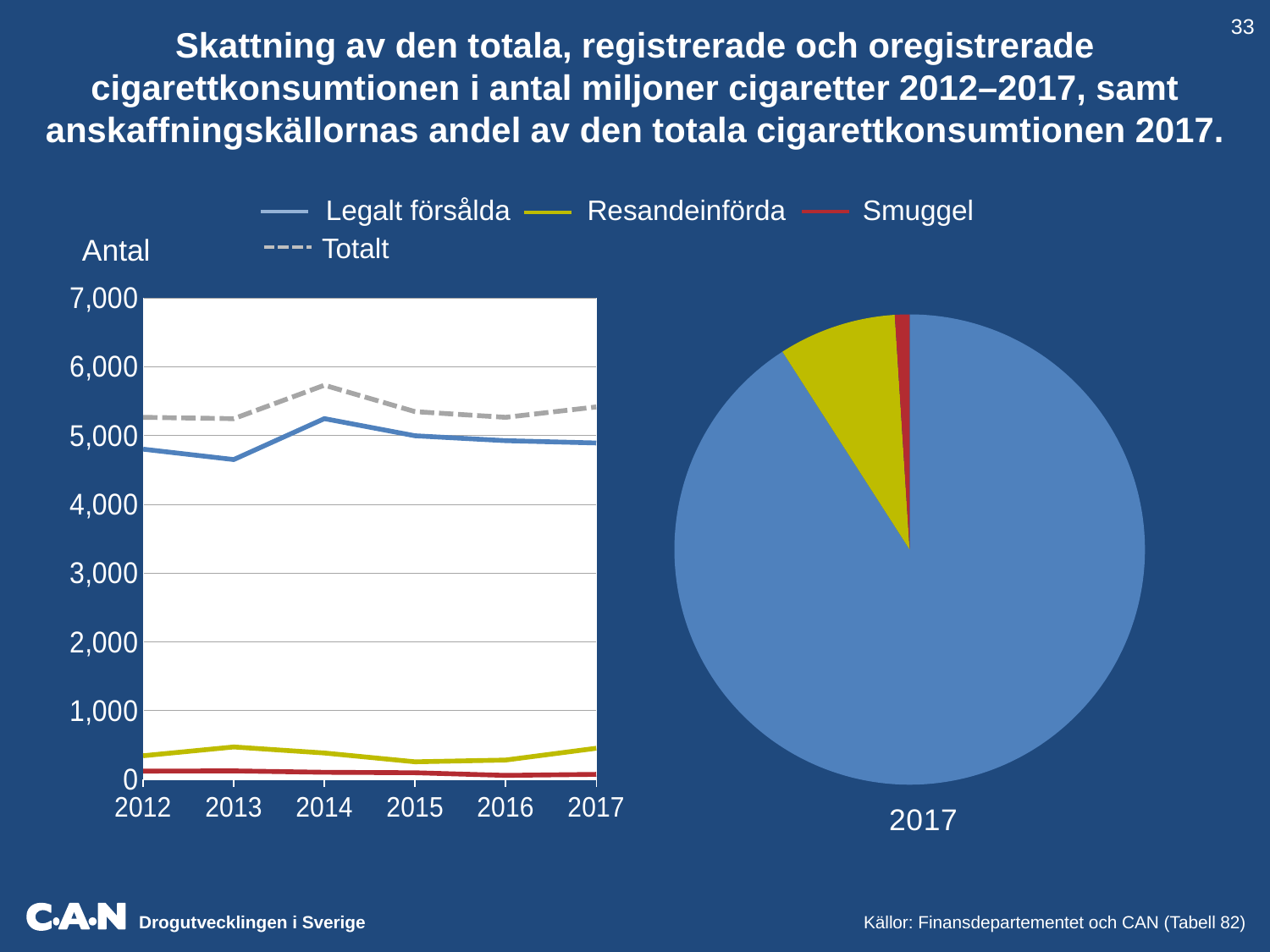
In the line chart on the left, is the value for Resandeinförda in 2013 greater or less than 1,000? less In the line chart on the left, is the value for Legalt försålda in 2014 greater or less than 5,000? greater In the line chart on the left, in which year is the Totalt line at its highest? 2014 In the pie chart on the right, how many slices are there? 3 In the line chart on the left, how many years are shown on the x axis? 6 In the pie chart on the right, which source has the smallest slice? Smuggel In the line chart on the left, which is larger in 2017: Legalt försålda or Smuggel? Legalt försålda In the line chart on the left, how many series does the legend list? 4 In the line chart on the left, is the value for Totalt in 2014 greater or less than 6,000? less In the line chart on the left, in which year is the Legalt försålda line at its lowest? 2013 What kind of chart is the chart on the right side of the slide? pie chart What kind of chart is the chart on the left side of the slide? line chart